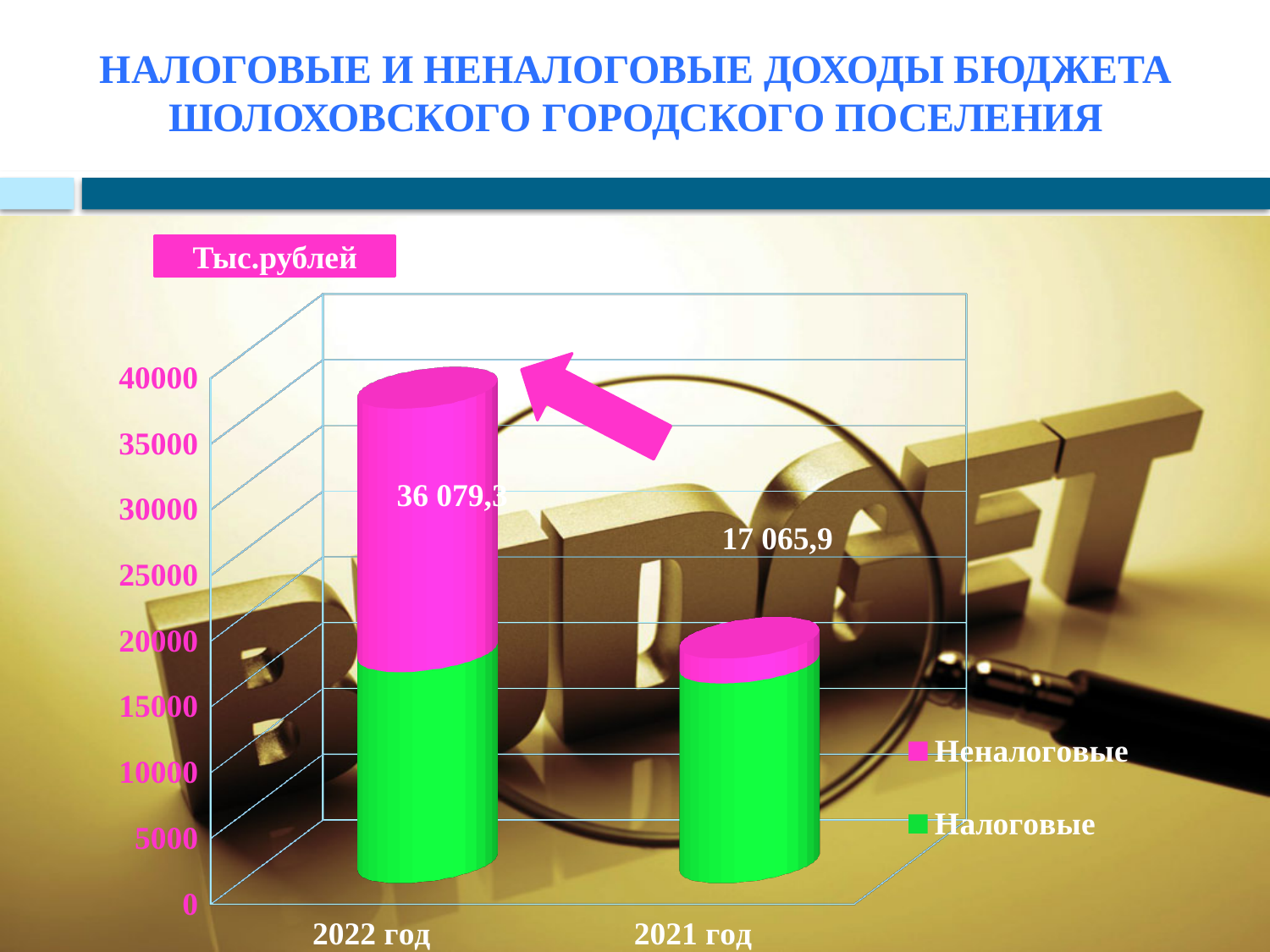
Which is larger, the labelled value for 2022 год or for 2021 год? 2022 год Which year has the taller bar? 2022 год Which year has the shorter bar? 2021 год What value is labelled for 2021 год? 17 065,9 Is the total height of the 2021 год bar greater or less than 10000? greater What is the difference between the labelled values for 2022 год and 2021 год? 19 013,4 What value is labelled on the bar for 2022 год? 36 079,3 Is the Налоговые (green) segment of the 2022 год bar greater or less than 10000? greater How many series does the legend list? 2 How many categories (years) are shown on the x axis? 2 What unit is stated in the pink box above the chart? Тыс.рублей What kind of chart is shown on the slide? bar chart